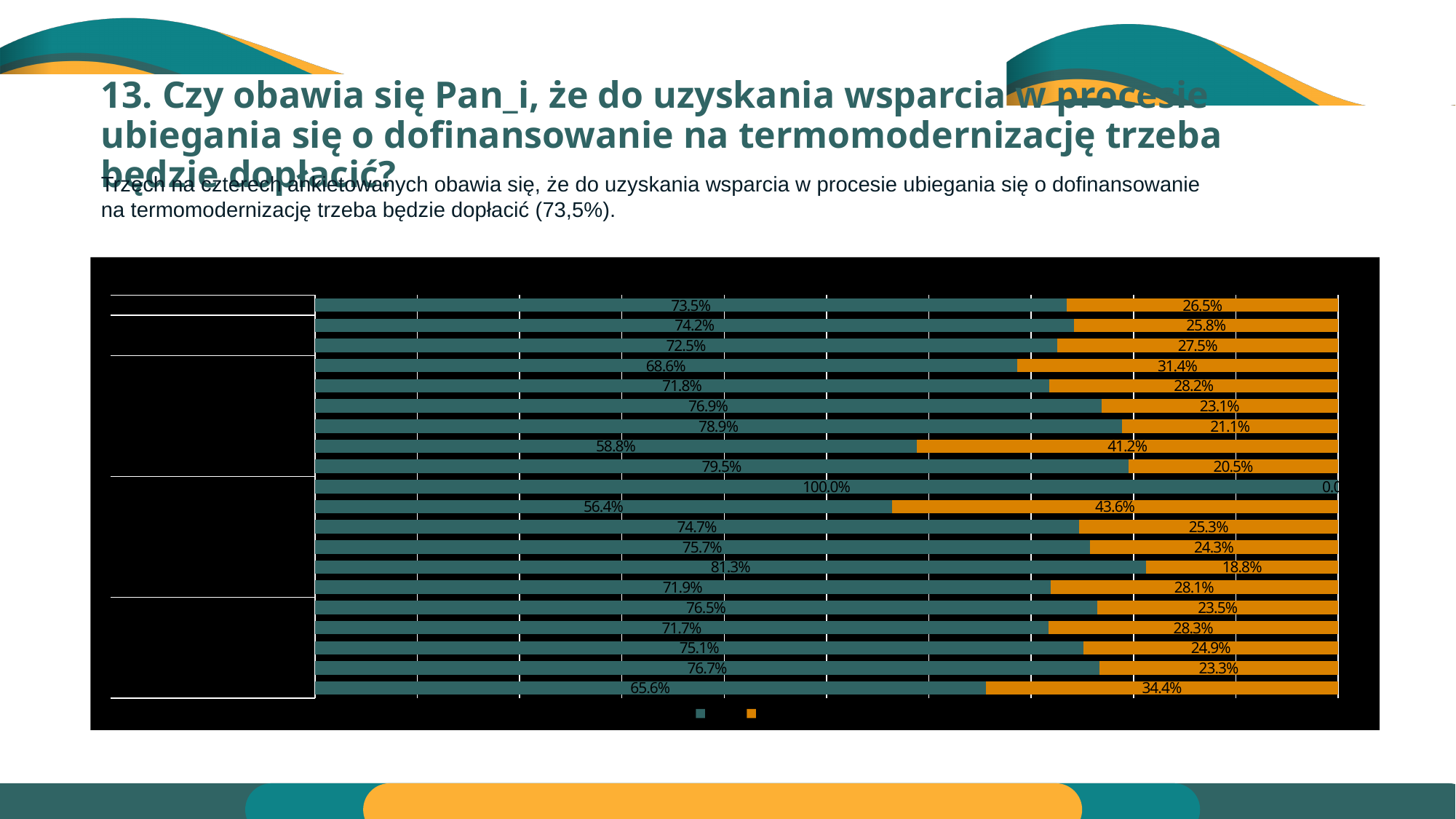
Which colour is used for the series with the larger values in the chart, teal or orange? teal What is the orange value of the topmost bar in the chart? 26.5% How many series does the legend of the chart list? 2 What is the highest value shown for the orange (right) series in the chart? 43.6% What is the lowest value shown for the orange (right) series in the chart? 0.0% How many bars are plotted in the chart? 20 What is the teal value of the bottom bar in the chart? 65.6% What is the teal value of the topmost bar in the chart? 73.5% What is the total of the teal and orange segments in the bottom bar of the chart? 100.0% What is the lowest value shown for the teal (left) series in the chart? 56.4% What kind of chart is shown on the slide? bar chart What is the highest value shown for the teal (left) series in the chart? 100.0%